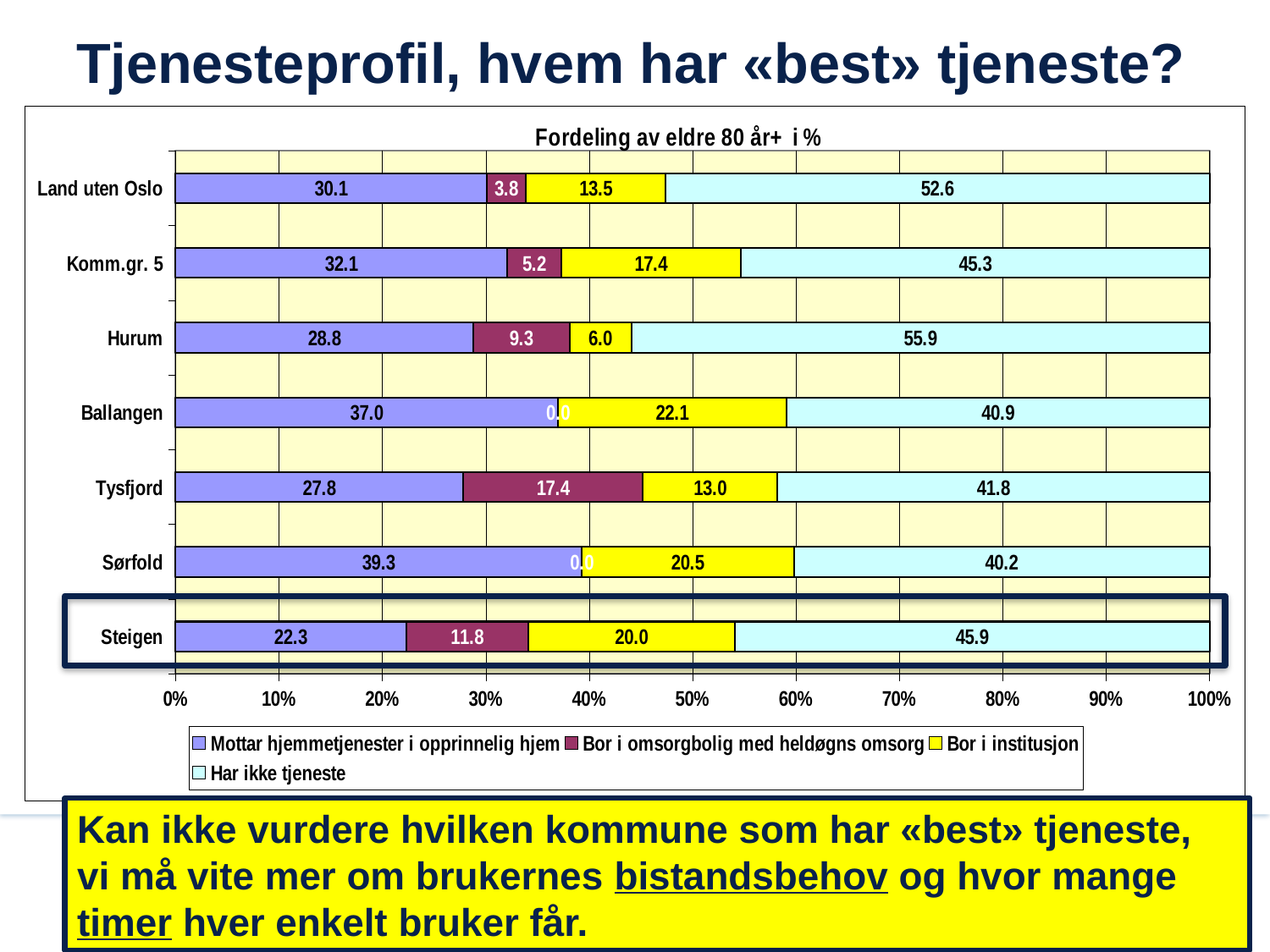
Which is larger: the 'Bor i institusjon' value for Ballangen or for Komm.gr. 5? Ballangen How many categories (rows) are shown in the chart? 7 What is the value of 'Mottar hjemmetjenester i opprinnelig hjem' for Steigen? 22.3 What is the title of the chart? Fordeling av eldre 80 år+ i % What is the difference between the 'Har ikke tjeneste' values for Land uten Oslo and Sørfold? 12.4 What kind of chart is shown on the slide? Stacked bar chart What is the value of 'Har ikke tjeneste' for Hurum? 55.9 What is the value of 'Bor i omsorgbolig med heldøgns omsorg' for Tysfjord? 17.4 How many series does the legend list? 4 Which category is highlighted with a box around its row? Steigen Which category has the lowest value for 'Bor i institusjon'? Hurum Which category has the highest value for 'Mottar hjemmetjenester i opprinnelig hjem'? Sørfold